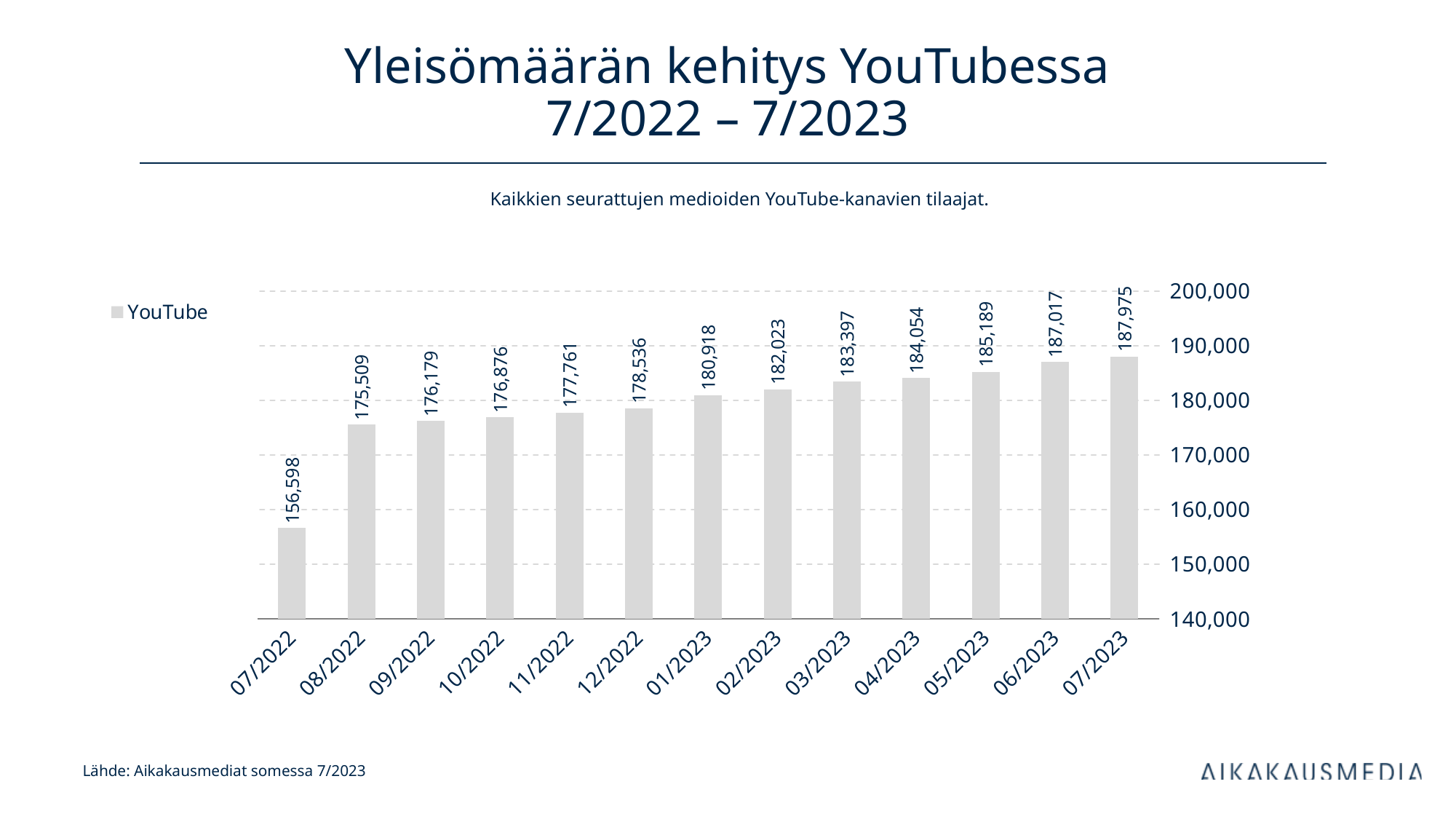
Is the value for 12/2022 greater or less than 180,000? less How many months are shown on the x axis? 13 What is the difference between the values for 08/2022 and 07/2022? 18,911 What is the difference between the values for 07/2023 and 07/2022? 31,377 Which month has the lowest value? 07/2022 Do the values rise or fall from 07/2022 to 07/2023? rise What is the value for 01/2023? 180,918 What kind of chart is shown on the slide? bar chart What is the value for 07/2022? 156,598 Which is larger, the value for 03/2023 or the value for 11/2022? 03/2023 What is the value for 07/2023? 187,975 Which month has the highest value? 07/2023